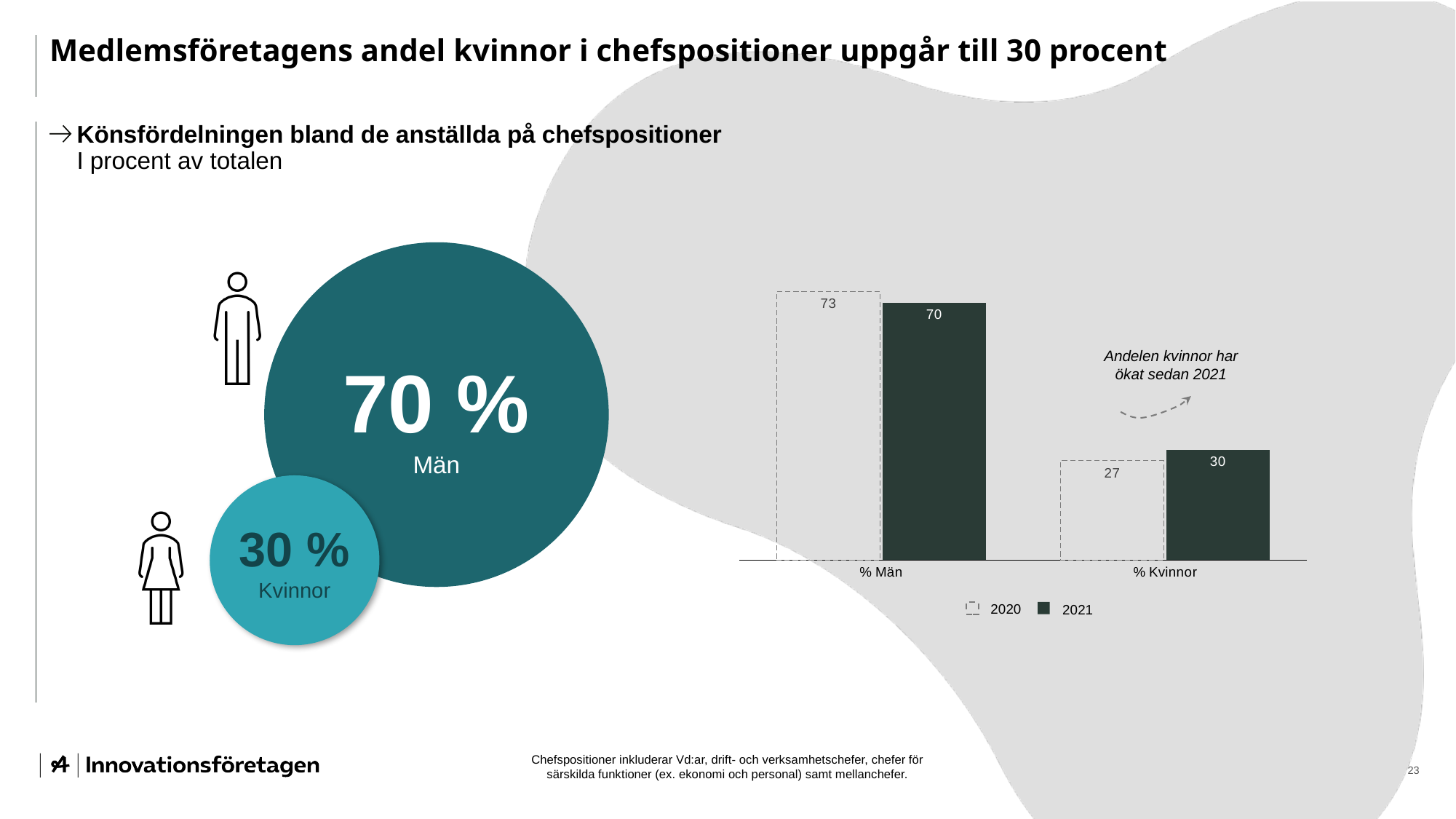
What is the value for % Män in 2021? 70 What is the value for % Kvinnor in 2021? 30 What is the difference between the 2020 and 2021 values for % Kvinnor? 3 Which category has the lowest value in the 2020 series? % Kvinnor What is the value for % Kvinnor in 2020? 27 What is the value for % Män in 2020? 73 Which is larger for % Kvinnor: the 2020 value or the 2021 value? 2021 What is the difference between the 2020 and 2021 values for % Män? 3 What kind of chart is shown on the right side of the slide? Bar chart How many categories are shown on the x axis of the bar chart? 2 Which category has the highest value in the 2021 series? % Män How many series does the legend of the bar chart list? 2